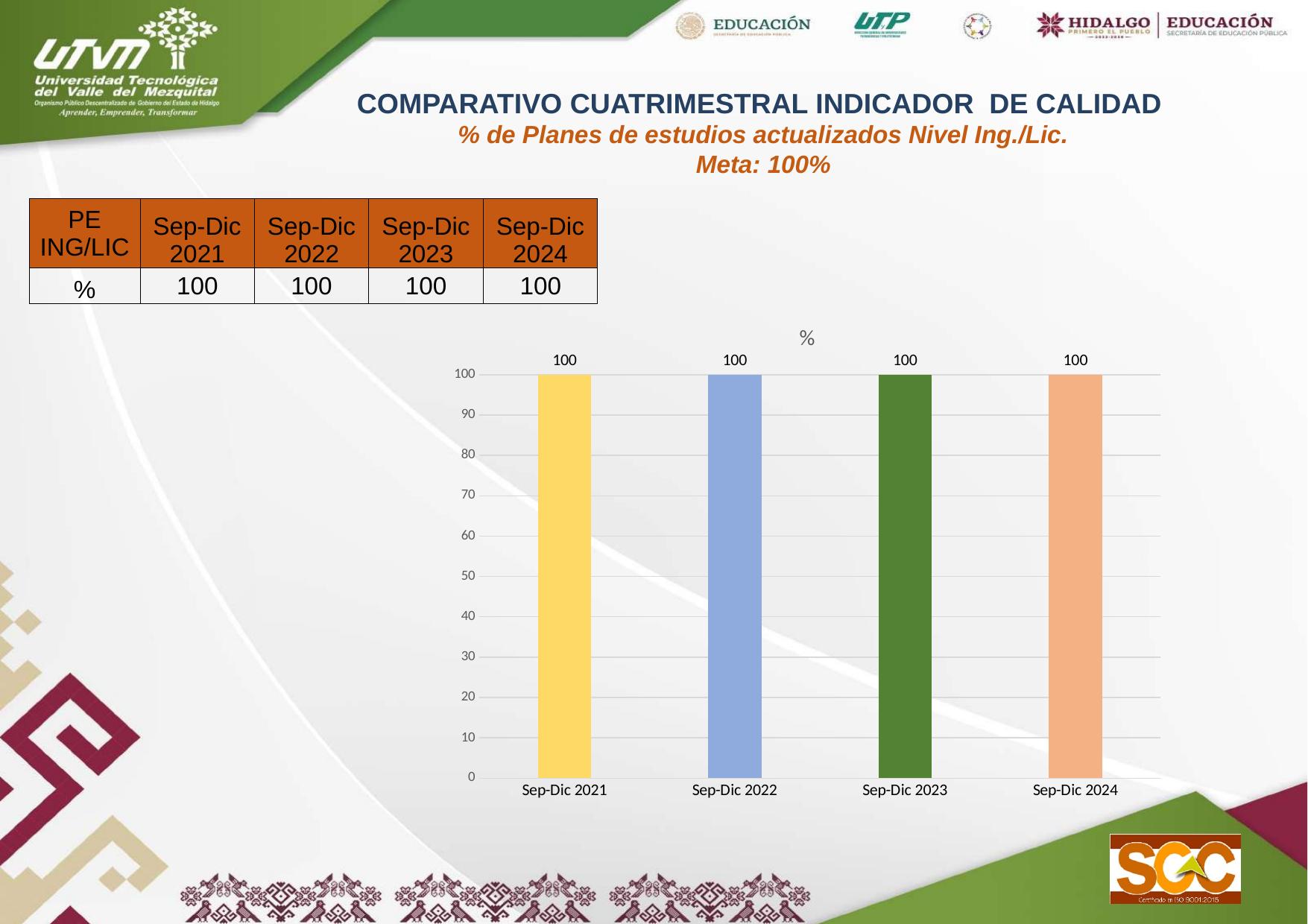
Do the values rise, fall or stay flat from Sep-Dic 2021 to Sep-Dic 2024? stay flat Is the value for Sep-Dic 2022 greater or less than 50? greater What is the value for Sep-Dic 2024? 100 What is the title of the chart? % What is the difference between the values for Sep-Dic 2022 and Sep-Dic 2024? 0 What is the highest value shown on the y axis of the chart? 100 What colour is the bar for Sep-Dic 2023? green What is the value for Sep-Dic 2021? 100 How many categories are shown on the x axis of the chart? 4 What kind of chart is shown on the slide? bar chart What is the value for Sep-Dic 2023? 100